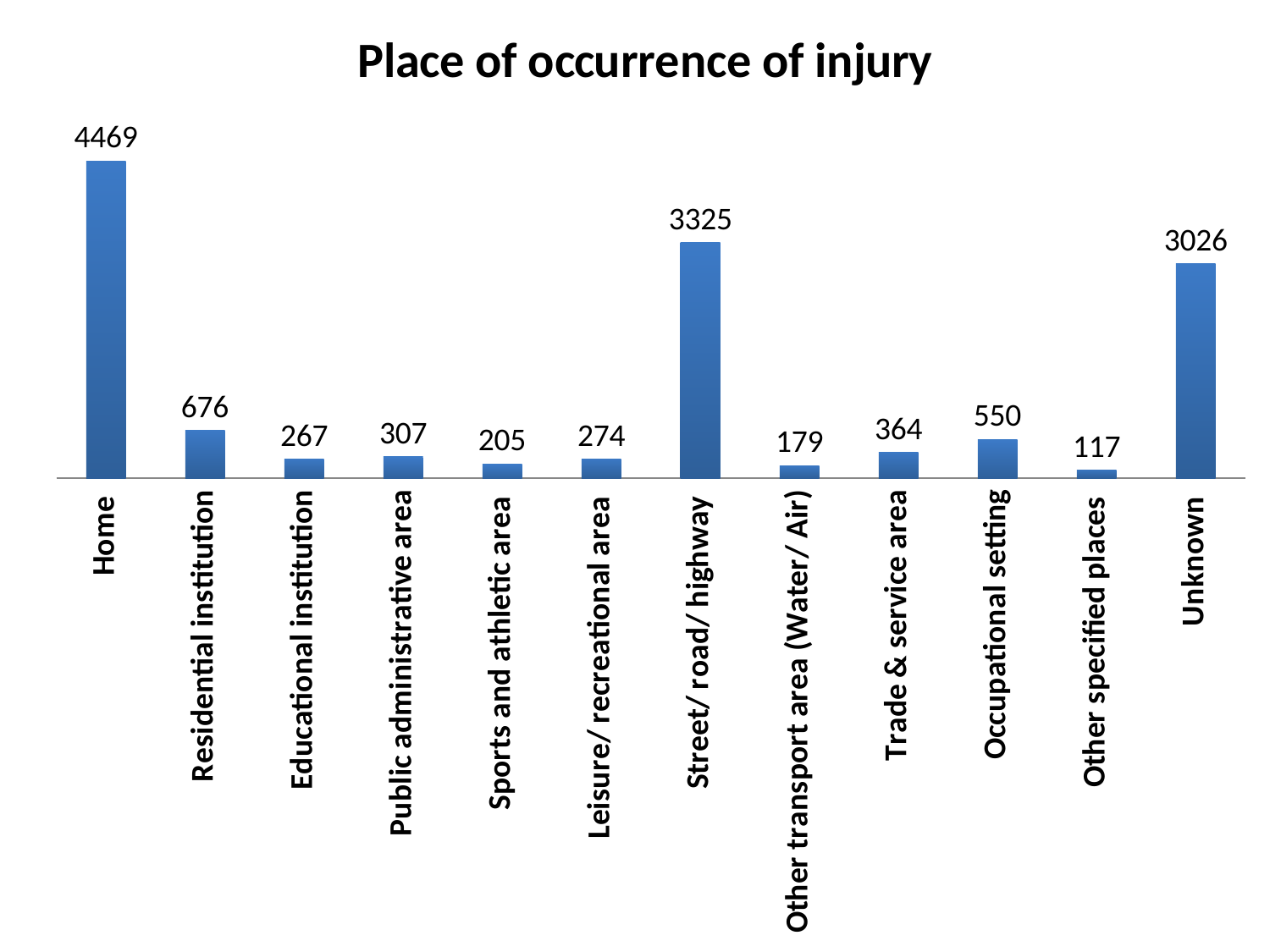
What is the value for Other transport area (Water/ Air)? 179 What is the value for Occupational setting? 550 What is the value for Home? 4469 What is the difference between the values for Residential institution and Trade & service area? 312 What is the difference between the values for Home and Unknown? 1443 What kind of chart is this? Bar chart Which place of occurrence has the lowest value? Other specified places Which is larger, the value for Public administrative area or the value for Leisure/ recreational area? Public administrative area Which place of occurrence has the highest value? Home What is the value for Street/ road/ highway? 3325 What is the title of the chart? Place of occurrence of injury How many categories are shown on the chart? 12